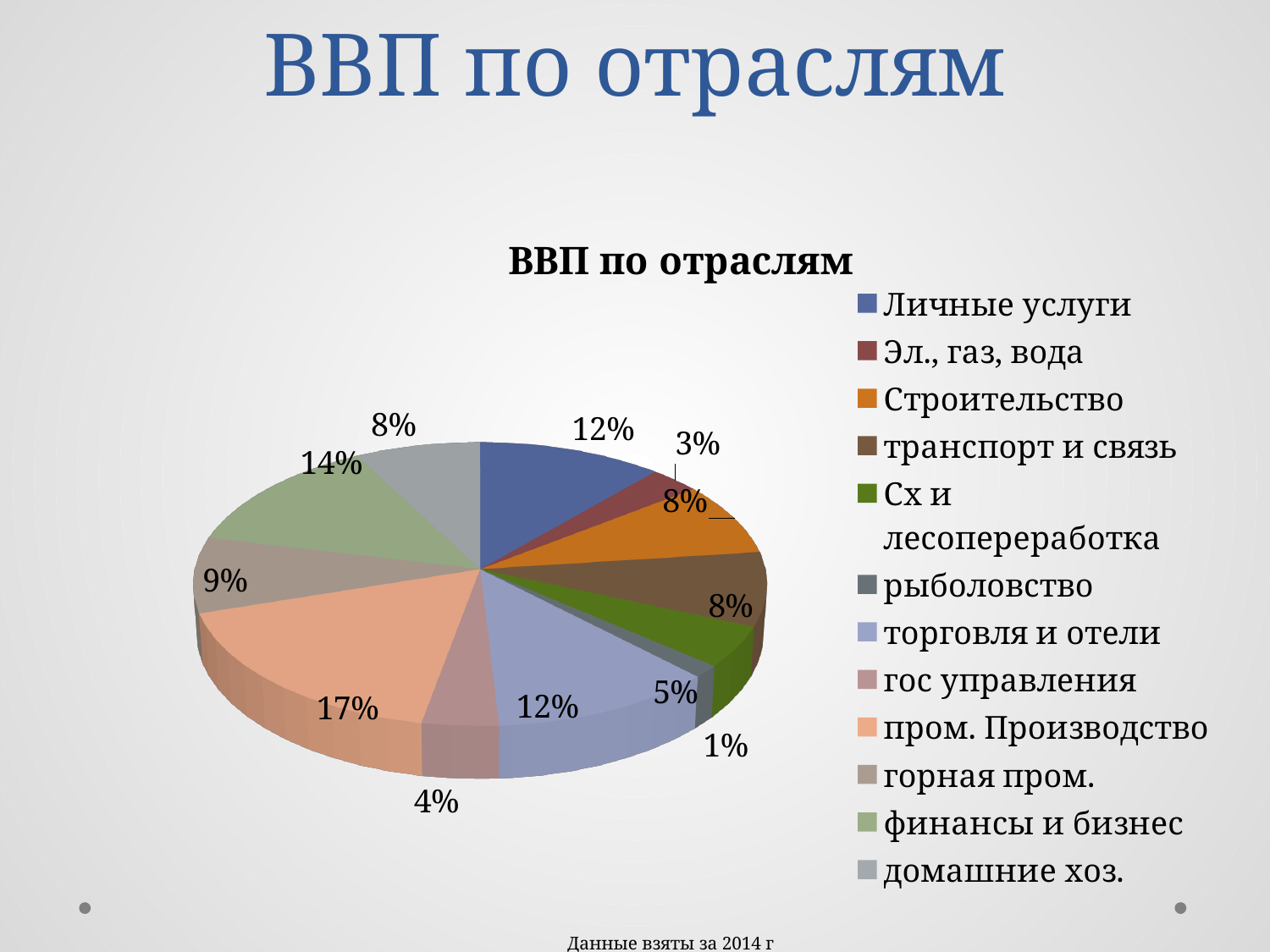
What share of the pie does пром. Производство have? 17% Which category has the smallest share of the pie? рыболовство What share of the pie does Эл., газ, вода have? 3% What is the title of the chart? ВВП по отраслям What is the difference between the shares of пром. Производство and горная пром.? 8% Which has a larger share, Личные услуги or Сх и лесопереработка? Личные услуги What share of the pie does финансы и бизнес have? 14% How many categories does the legend list? 12 Which category has the largest share of the pie? пром. Производство What share of the pie does рыболовство have? 1% What share of the pie does гос управления have? 4% What kind of chart is shown on the slide? pie chart